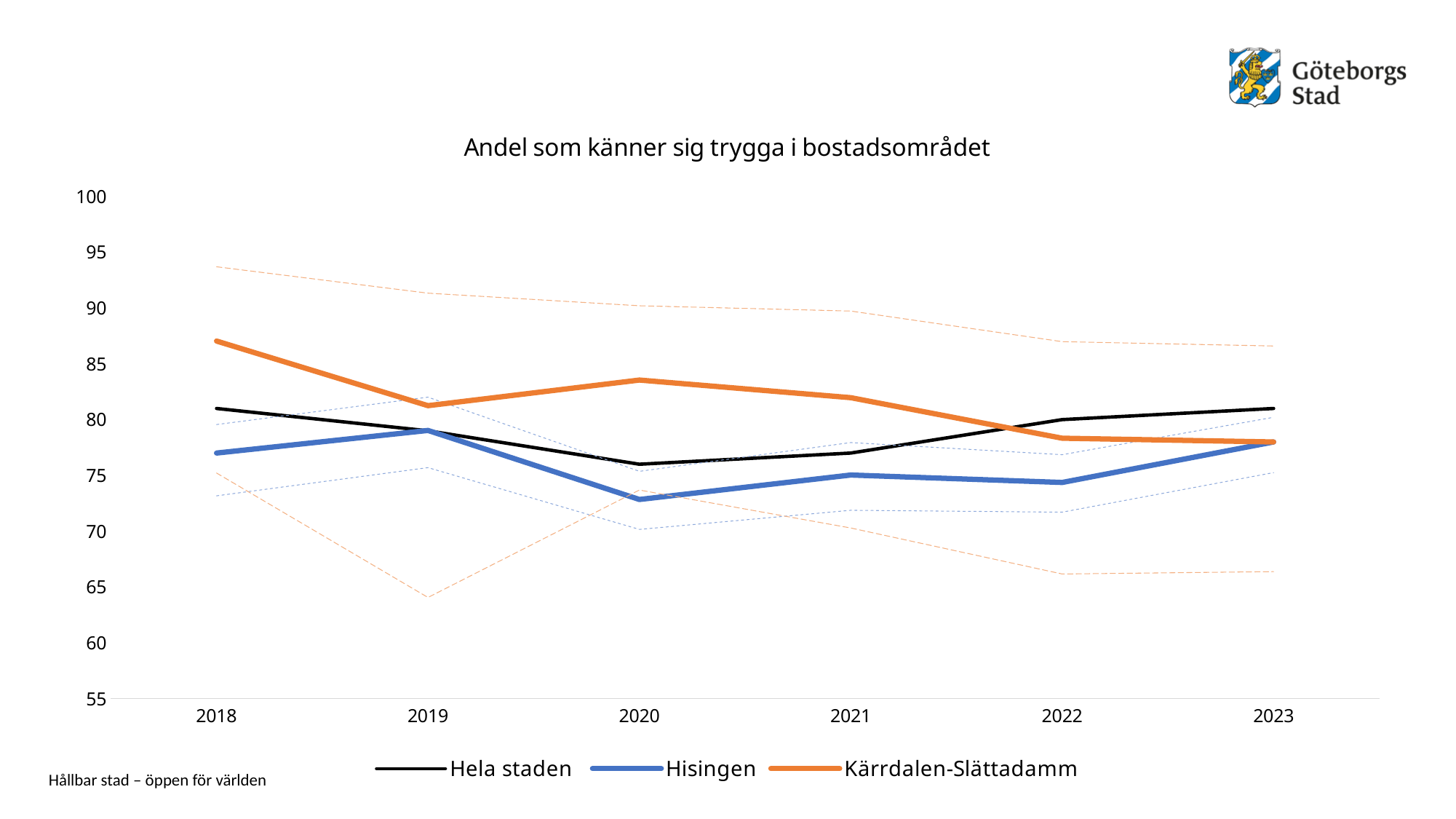
Is the value for Hisingen in 2018 greater or less than 80? less Which series is drawn in orange? Kärrdalen-Slättadamm In 2022, which is larger: Hela staden or Hisingen? Hela staden How many years are shown on the x axis? 6 Is the value for Kärrdalen-Slättadamm in 2018 greater or less than 85? greater How many series does the legend list? 3 What is the title of the chart? Andel som känner sig trygga i bostadsområdet Is the value for Kärrdalen-Slättadamm in 2020 greater or less than 80? greater In which year does Kärrdalen-Slättadamm reach its highest value? 2018 What kind of chart is shown on the slide? line chart Which series has the highest value in 2018? Kärrdalen-Slättadamm